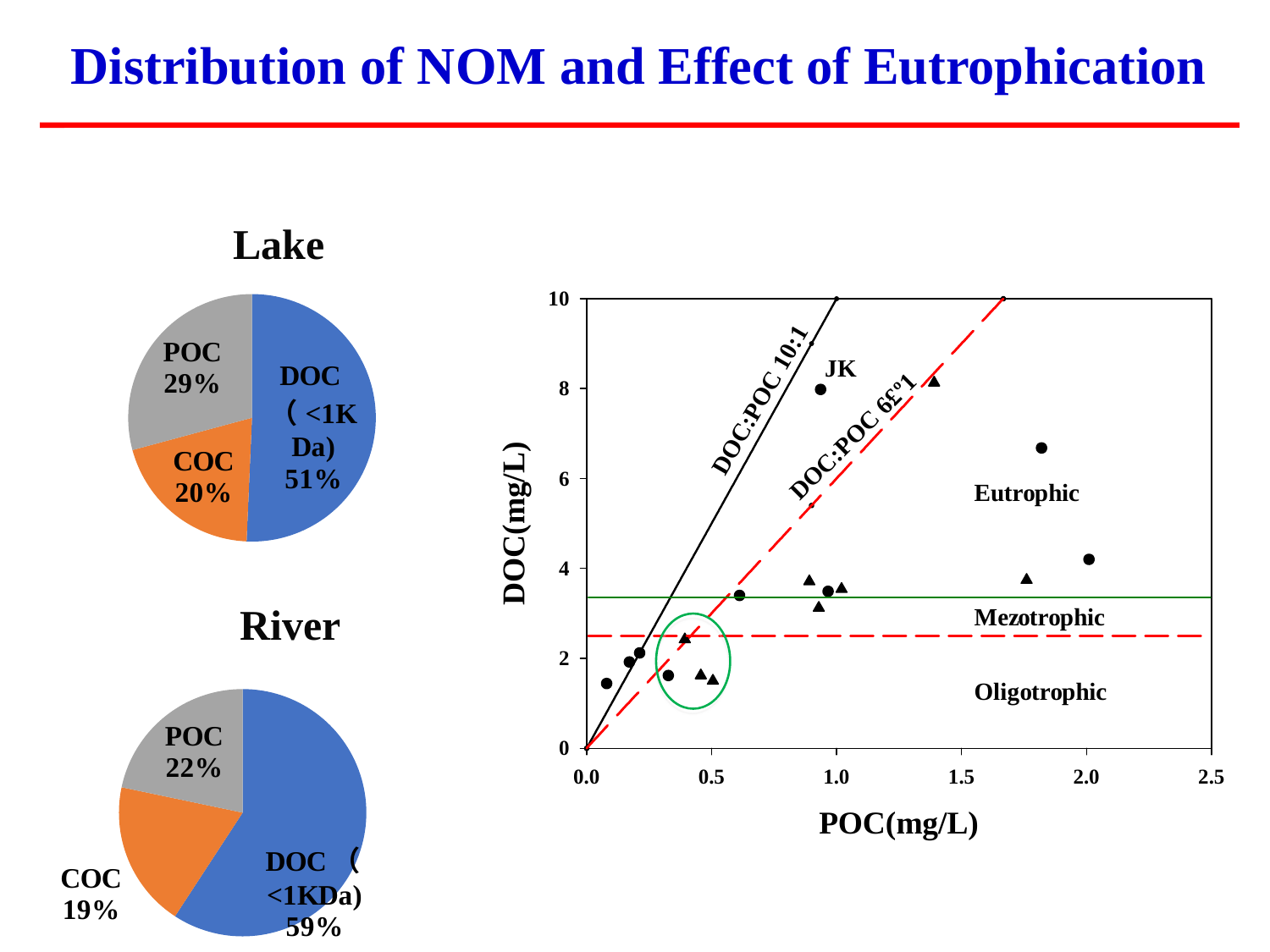
Comparing the Lake and River pie charts, which has the larger POC share? Lake In the River pie chart, what percentage is POC? 22% In the Lake pie chart, which category has the smallest share? COC In the Lake pie chart, which category has the largest share? DOC (<1K Da) How many slices does the River pie chart have? 3 What kind of chart is the chart on the right of the slide? Scatter plot In the River pie chart, what is the difference between the DOC (<1KDa) and COC percentages? 40% In the Lake pie chart, what percentage is DOC (<1K Da)? 51% In the River pie chart, what percentage is COC? 19% In the scatter plot on the right, what is the x-axis label? POC(mg/L) In the Lake pie chart, what is the difference between the POC and COC percentages? 9% In the scatter plot on the right, is the DOC value of the point labelled JK greater or less than 6? greater